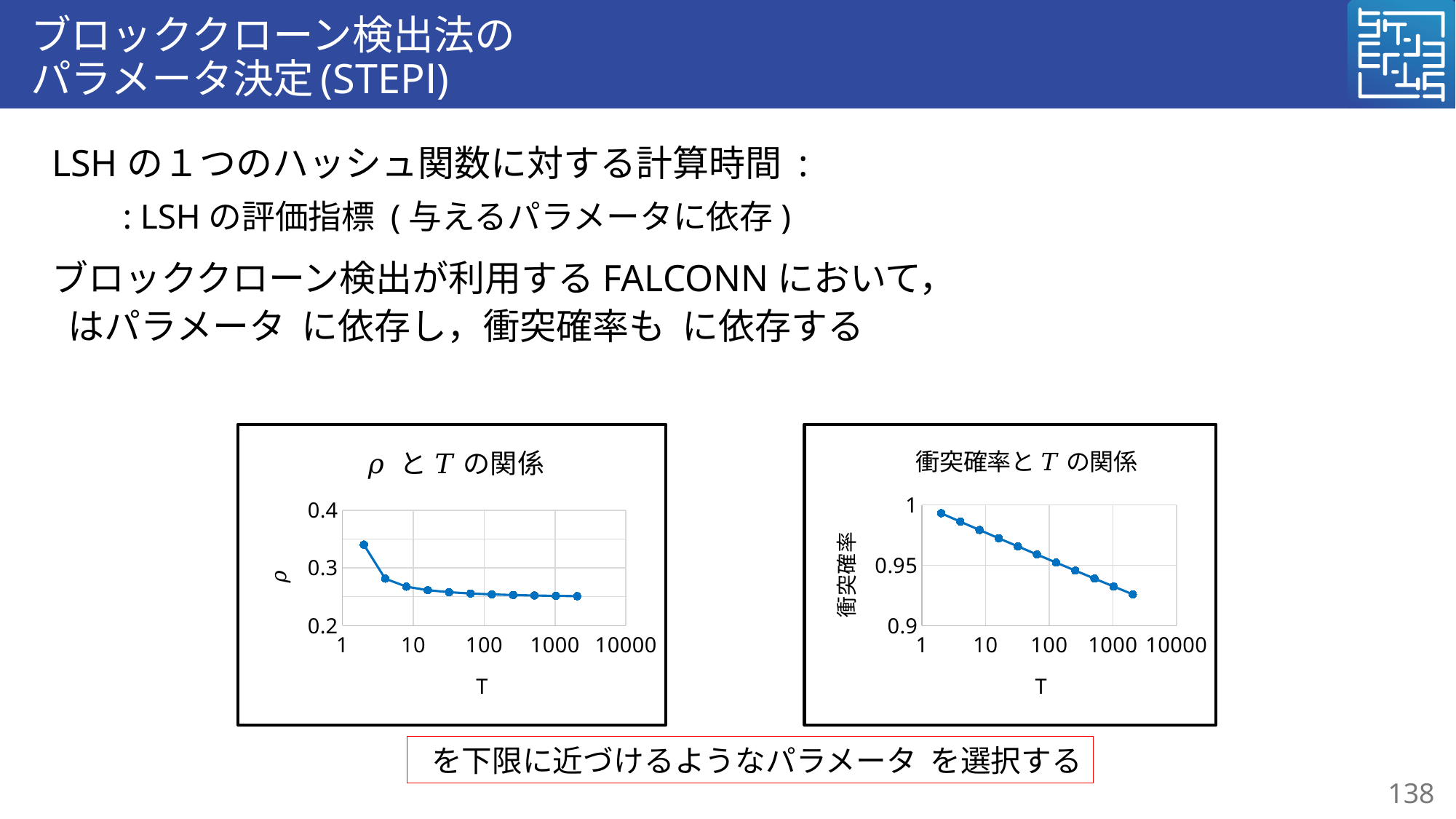
In the left chart "ρ と T の関係", do the values of ρ rise or fall as T increases? fall What is the label of the horizontal axis in the left chart "ρ と T の関係"? T What kind of chart is the left chart titled "ρ と T の関係"? line chart What kind of chart is the right chart titled "衝突確率と T の関係"? line chart How many data points are plotted in the left chart "ρ と T の関係"? 11 What is the label of the vertical axis in the right chart "衝突確率と T の関係"? 衝突確率 In the left chart "ρ と T の関係", is the value of ρ at the largest T greater or less than 0.3? less In the left chart "ρ と T の関係", is the value of ρ at the smallest T greater or less than 0.3? greater In the right chart "衝突確率と T の関係", do the values of 衝突確率 rise or fall as T increases? fall How many data points are plotted in the right chart "衝突確率と T の関係"? 11 In the right chart "衝突確率と T の関係", is the value of 衝突確率 at the largest T greater or less than 0.95? less